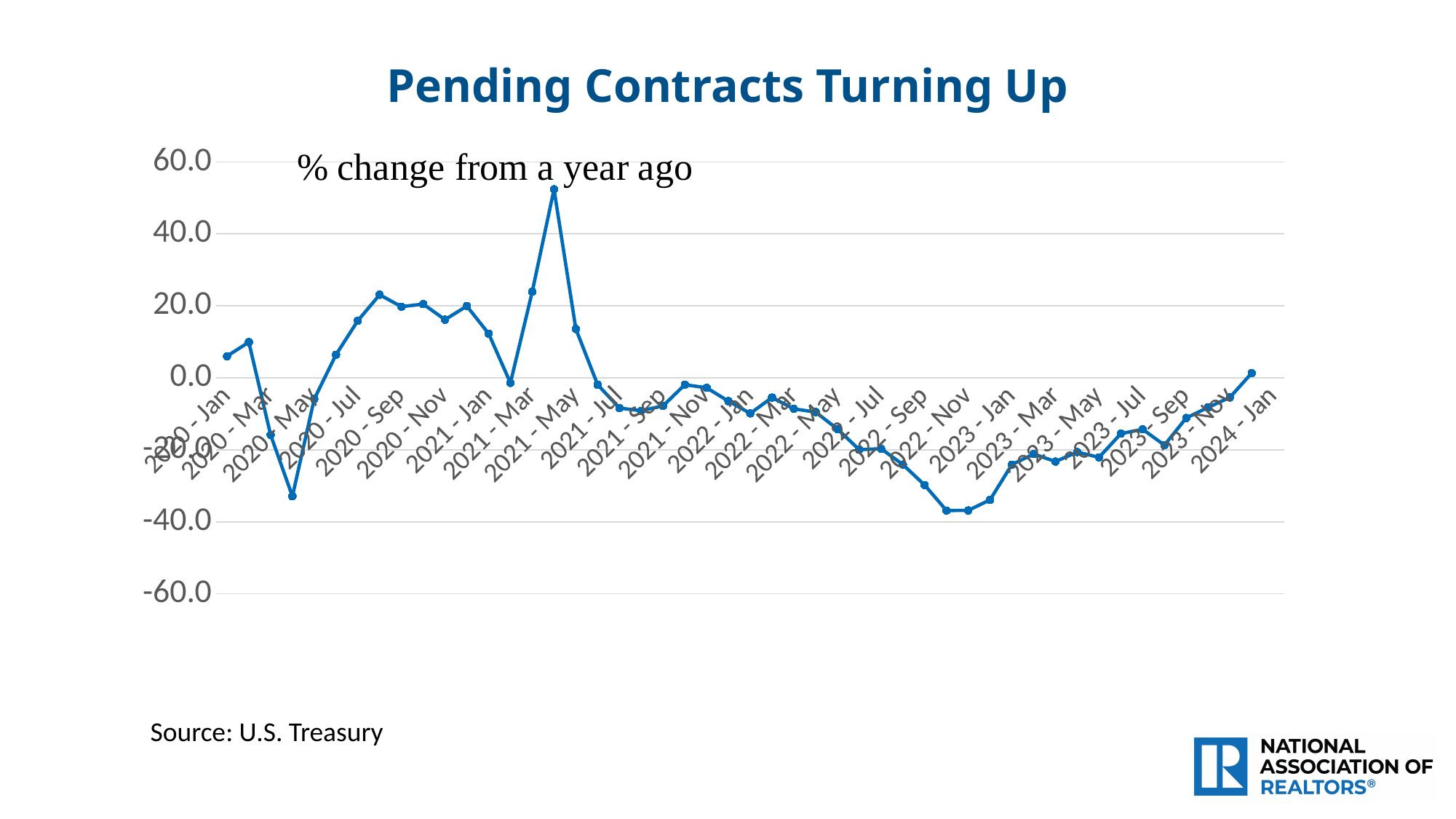
What is the title of the chart? Pending Contracts Turning Up What measure does the chart plot, according to the label inside the plot area? % change from a year ago Do the values generally rise or fall from 2022 - Nov to 2024 - Jan? Rise Is the value for 2023 - Jan greater or less than -20? less What kind of chart is shown on the slide? Line chart In which year does the line reach its lowest point? 2022 In which year does the line reach its highest point? 2021 Is the value for 2020 - Jul greater or less than 0? greater How many data series are plotted on the chart? 1 Which is larger, the value for 2020 - Jan or the value for 2022 - Nov? 2020 - Jan How many labels are shown on the x axis? 25 Is the value for 2022 - Nov greater or less than -20? less